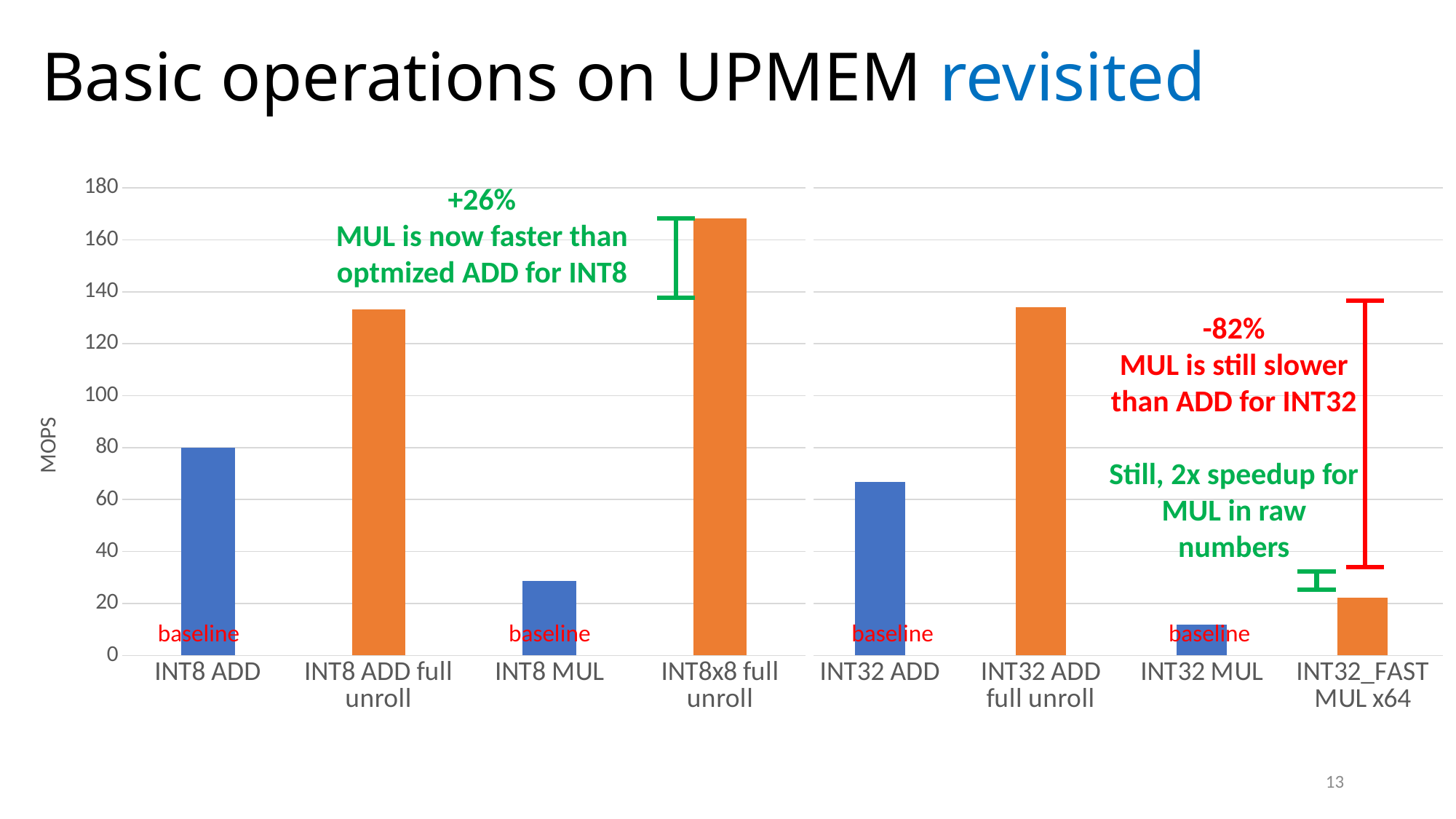
Which category has the lowest bar? INT32 MUL Which is larger, the value for INT8 ADD or the value for INT8 MUL? INT8 ADD Which category has the highest bar? INT8x8 full unroll What percentage change is annotated in green above the INT8x8 full unroll bar? +26% What kind of chart is shown on the slide? bar chart Is the value for INT8x8 full unroll greater or less than 160? greater Is the value for INT32_FAST MUL x64 greater or less than 40? less How many categories are plotted on the x axis? 8 Which is larger, the value for INT32 MUL or the value for INT32_FAST MUL x64? INT32_FAST MUL x64 What is the label on the y axis? MOPS Is the value for INT8 MUL greater or less than 40? less